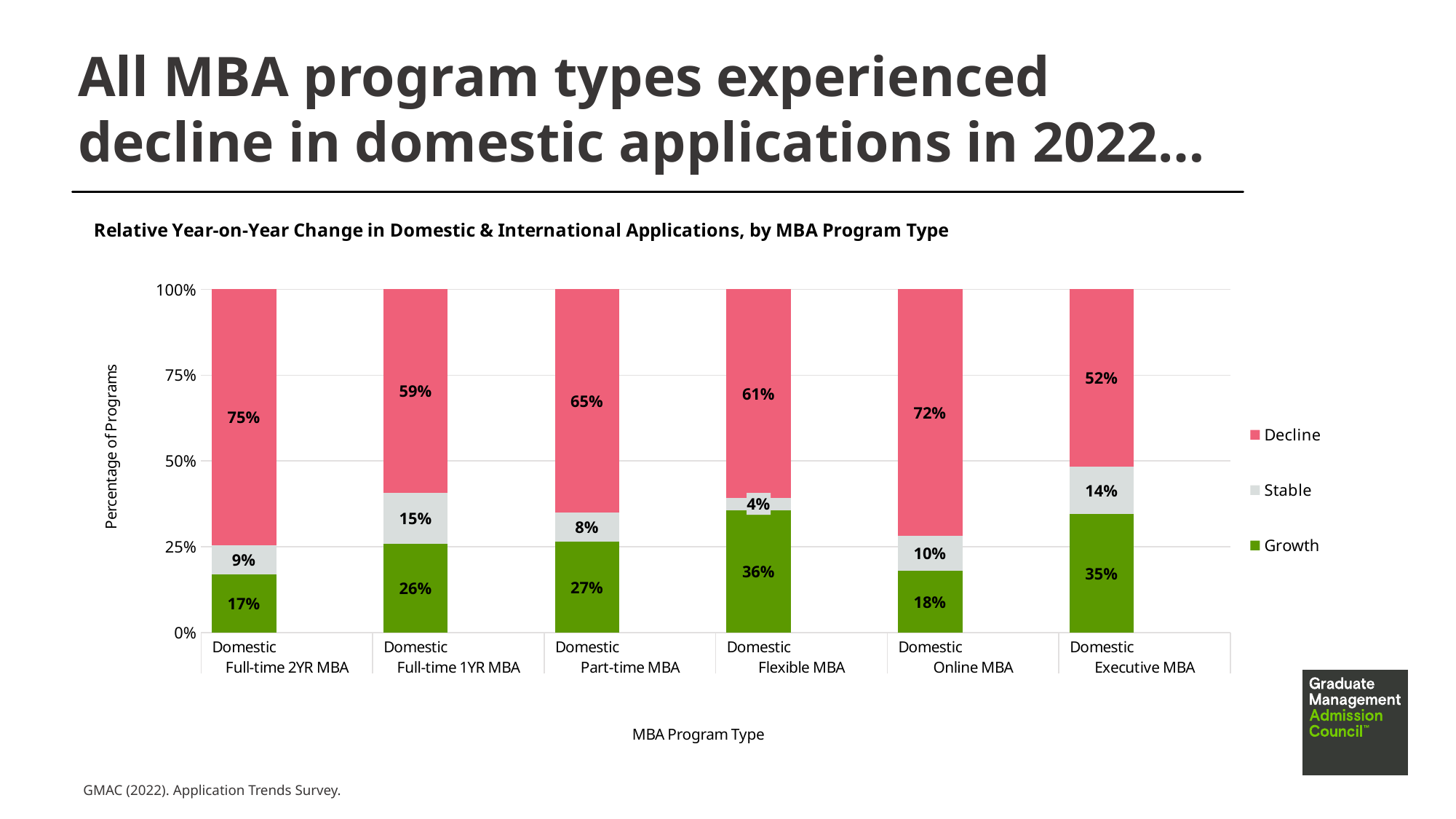
What is the Growth value for Domestic Flexible MBA? 36% What is the difference between the Decline percentages for Domestic Online MBA and Domestic Executive MBA? 20% How many series does the legend list? 3 What is the label of the y axis? Percentage of Programs Which program type has the lowest Stable percentage? Domestic Flexible MBA What percentage of Domestic Full-time 2YR MBA programs reported a Decline? 75% What kind of chart is shown on the slide? Stacked bar chart Which program type has the highest Decline percentage? Domestic Full-time 2YR MBA Which program type has the lowest Growth percentage? Domestic Full-time 2YR MBA How many MBA program types are shown on the x axis? 6 What is the Stable value for Domestic Executive MBA? 14% Which has a larger Growth percentage, Domestic Part-time MBA or Domestic Online MBA? Domestic Part-time MBA